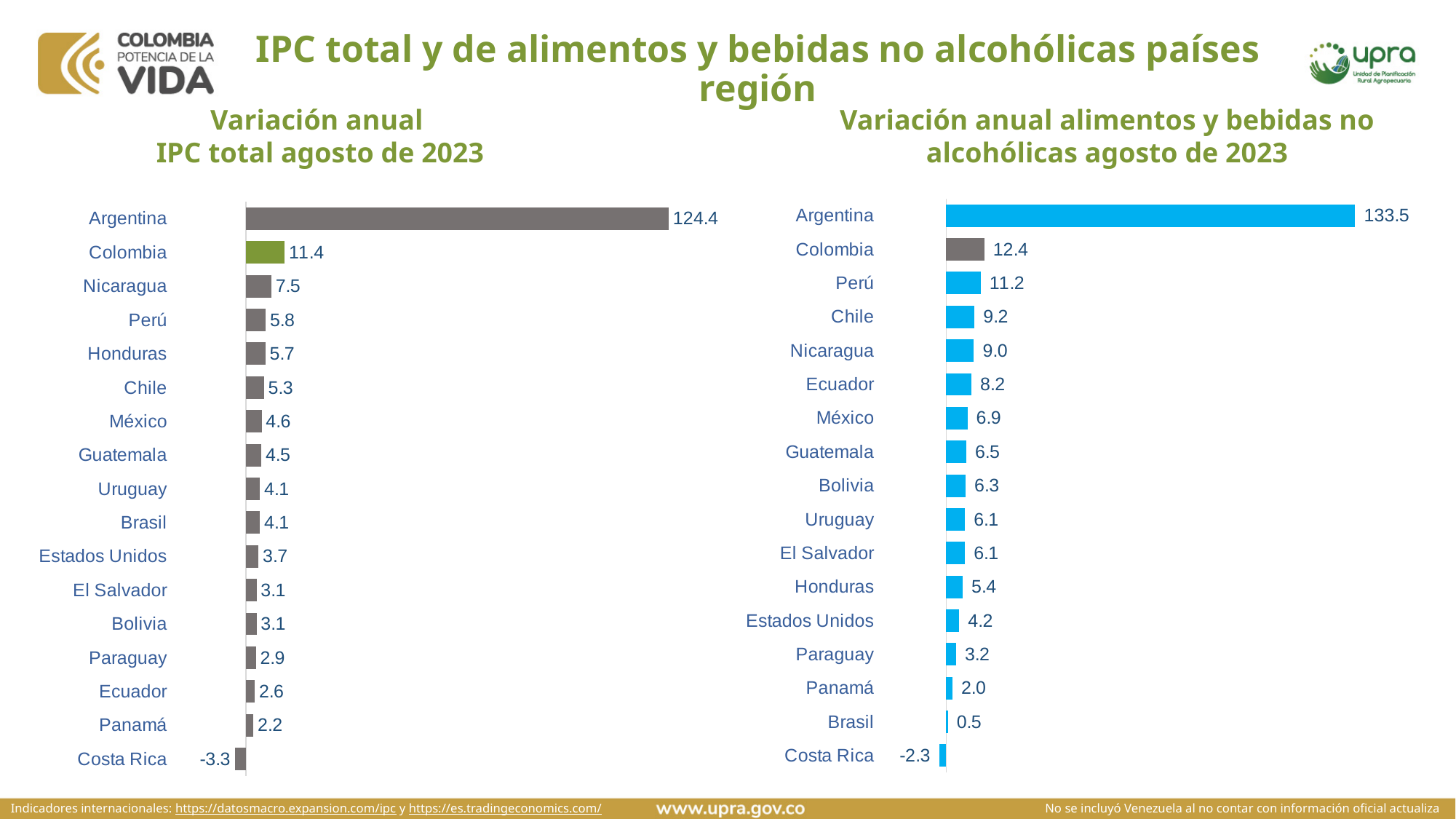
In the 'Variación anual IPC total agosto de 2023' chart, which country's bar is coloured green instead of grey? Colombia In the 'Variación anual IPC total agosto de 2023' chart, which country has the highest value? Argentina How many countries are shown in the 'Variación anual IPC total agosto de 2023' chart? 17 How many countries are shown in the 'Variación anual alimentos y bebidas no alcohólicas agosto de 2023' chart? 17 What type of chart is the 'Variación anual IPC total agosto de 2023' chart? Bar chart In the 'Variación anual alimentos y bebidas no alcohólicas agosto de 2023' chart, what is the value for Perú? 11.2 In the 'Variación anual alimentos y bebidas no alcohólicas agosto de 2023' chart, what is the difference between the values for Argentina and Colombia? 121.1 In the 'Variación anual alimentos y bebidas no alcohólicas agosto de 2023' chart, which country has the lowest value? Costa Rica In the 'Variación anual IPC total agosto de 2023' chart, what is the value for Costa Rica? -3.3 In the 'Variación anual IPC total agosto de 2023' chart, what is the value for Colombia? 11.4 In the 'Variación anual IPC total agosto de 2023' chart, what is the difference between the values for Argentina and Colombia? 113.0 In the 'Variación anual alimentos y bebidas no alcohólicas agosto de 2023' chart, which is larger, the value for Chile or the value for Ecuador? Chile